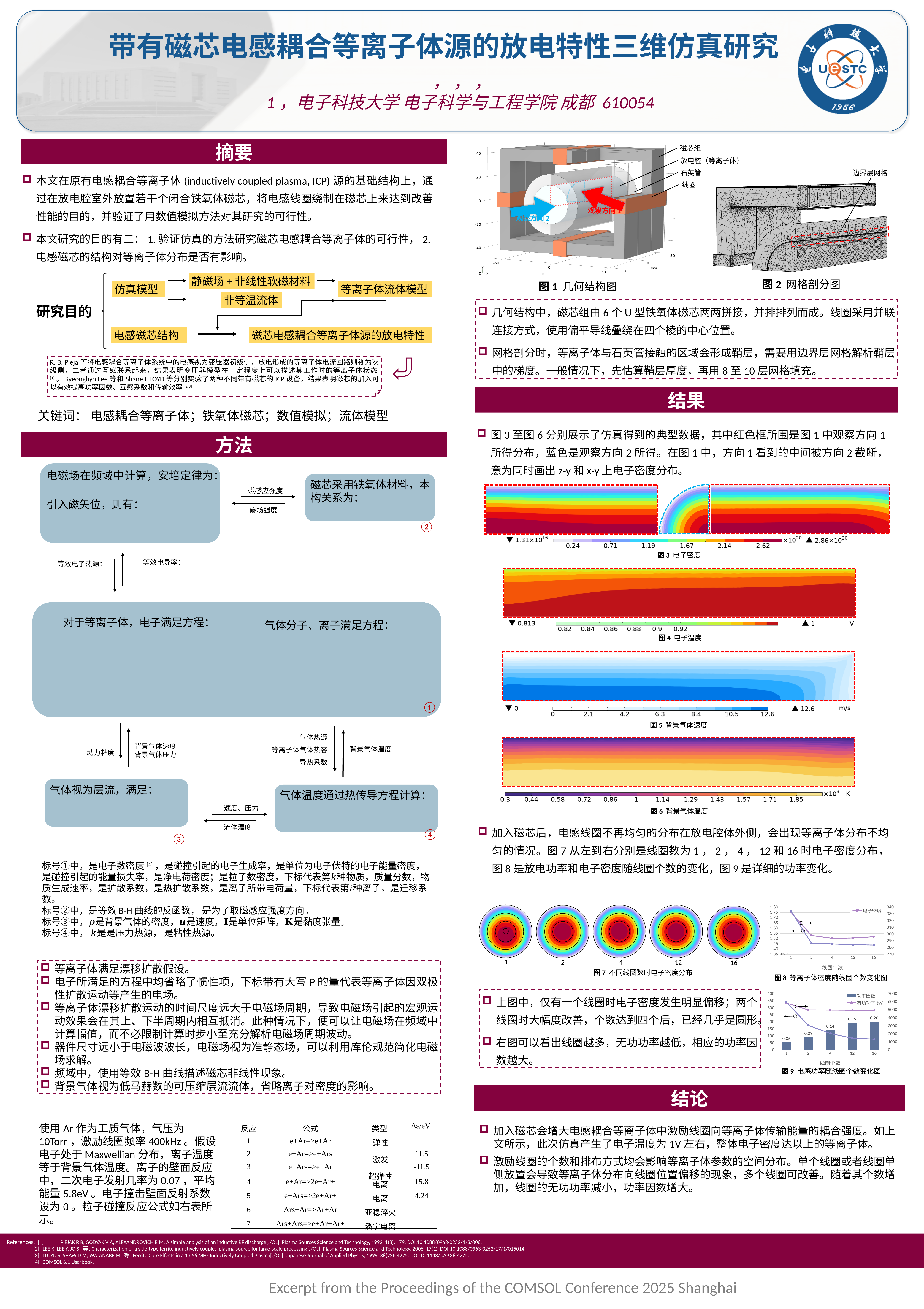
In 图 8 (等离子体密度随线圈个数变化图), does the 电子密度 line rise or fall as the number of coils increases? falls In 图 9 (电感功率随线圈个数变化图), which coil count has the highest 功率因数? 16 In 图 9 (电感功率随线圈个数变化图), what is the 功率因数 value when the number of coils is 4? 0.14 In 图 9 (电感功率随线圈个数变化图), what is the difference in 功率因数 between 16 coils and 1 coil? 0.15 In 图 9 (电感功率随线圈个数变化图), how many series does the legend list? 2 In 图 9 (电感功率随线圈个数变化图), which has a larger 功率因数: 2 coils or 12 coils? 12 coils In 图 9 (电感功率随线圈个数变化图), does the 功率因数 rise or fall as the number of coils increases? rises In 图 9 (电感功率随线圈个数变化图), what is the 功率因数 value when the number of coils is 12? 0.19 In 图 9 (电感功率随线圈个数变化图), how many coil-count categories are shown on the x axis? 5 In 图 9 (电感功率随线圈个数变化图), what is the 功率因数 value when the number of coils is 1? 0.05 In 图 9 (电感功率随线圈个数变化图), which coil count has the lowest 功率因数? 1 In 图 9 (电感功率随线圈个数变化图), what is the 功率因数 value when the number of coils is 16? 0.20